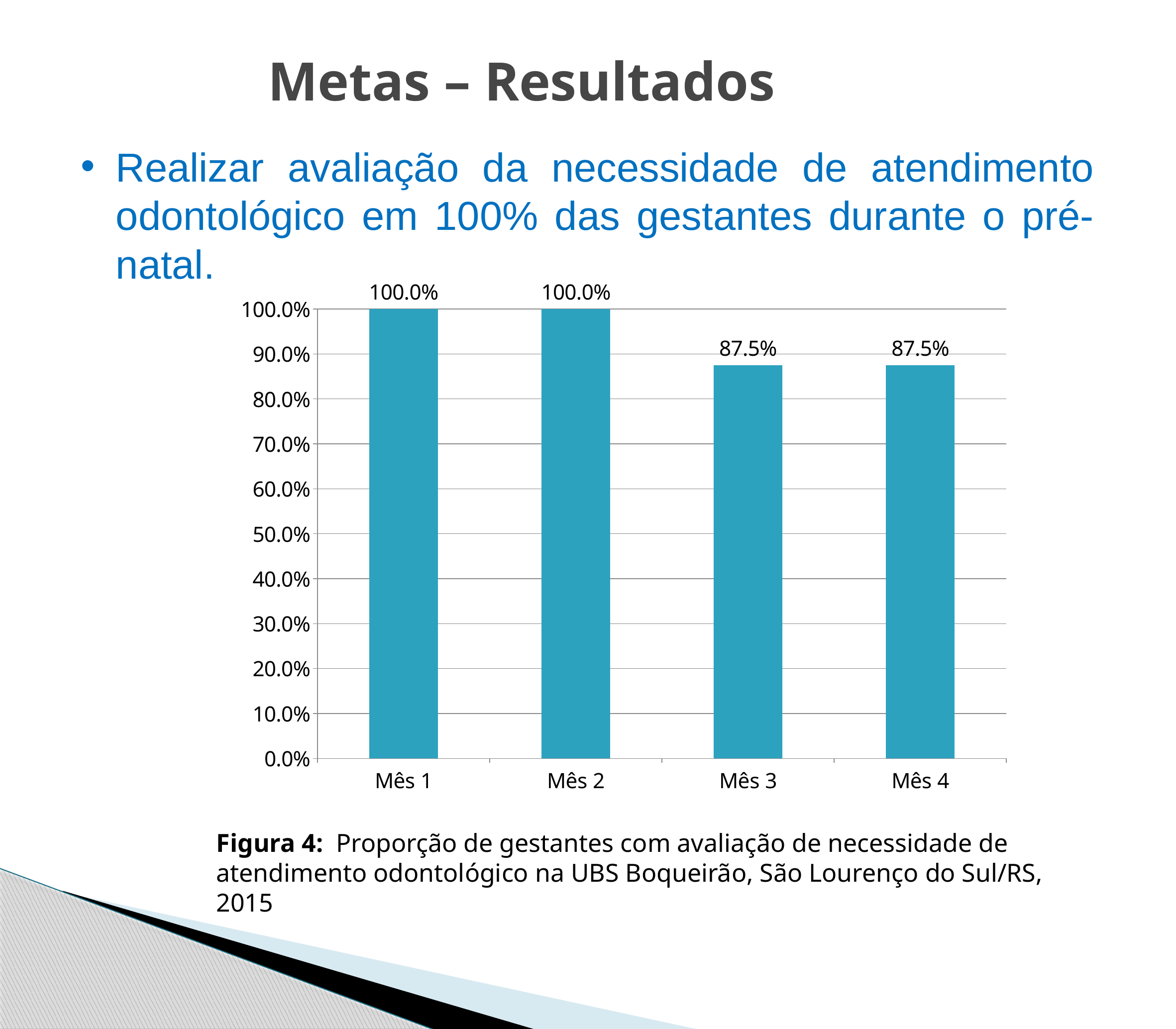
What kind of chart is shown on the slide? bar chart What is the figure number given in the caption below the chart? Figura 4 How many categories are shown on the x axis? 4 What is the value for Mês 1? 100.0% Which is larger, the value for Mês 1 or the value for Mês 4? Mês 1 What is the value for Mês 2? 100.0% Do the values rise or fall from Mês 2 to Mês 3? fall What colour are the bars in the chart? blue Is the value for Mês 3 greater or less than 90.0%? less What is the value for Mês 4? 87.5% What is the difference between the values for Mês 2 and Mês 3? 12.5% What is the value for Mês 3? 87.5%